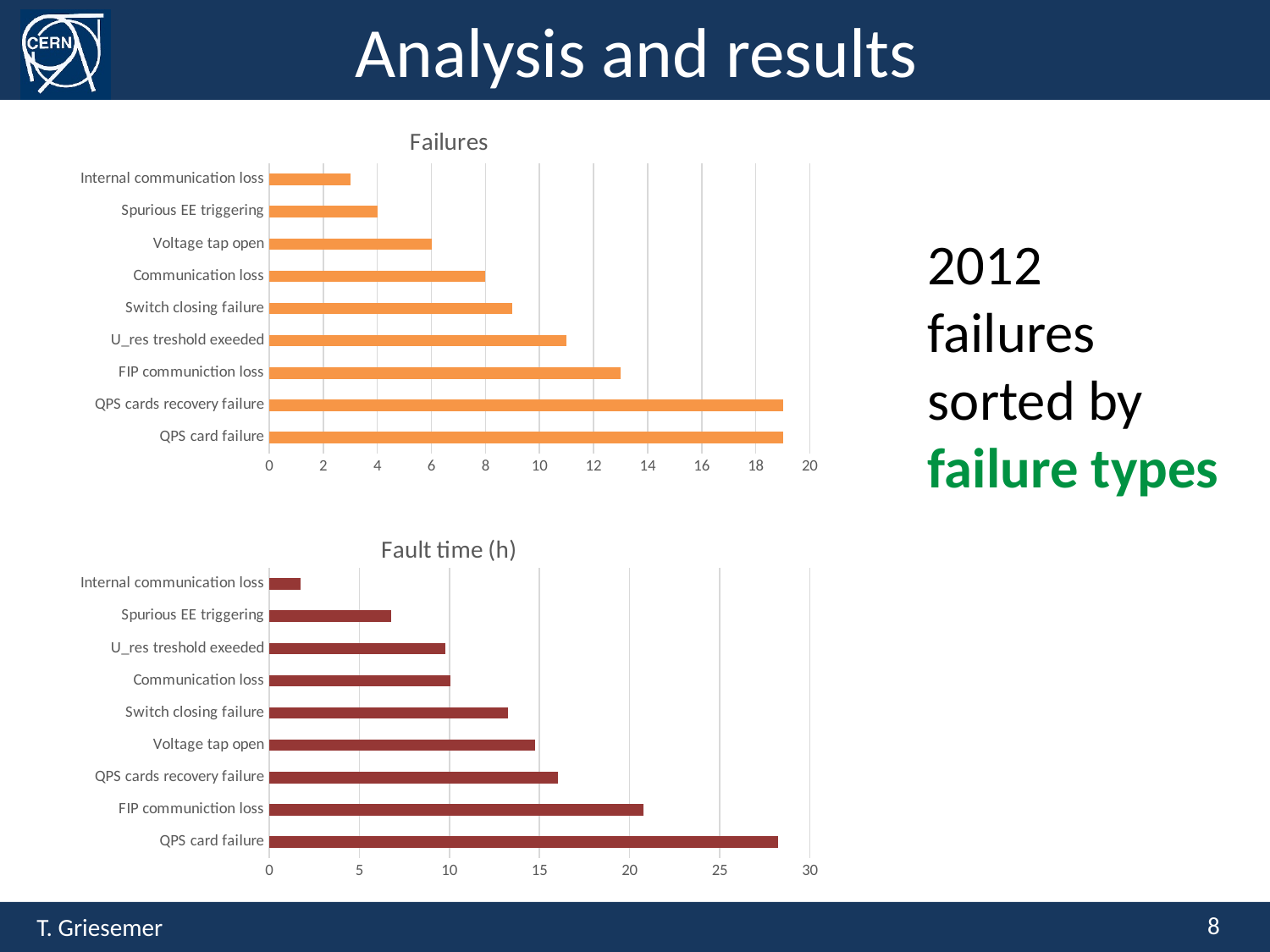
In the "Failures" chart, which category has the lowest value? Internal communication loss In the "Fault time (h)" chart, which category has the lowest value? Internal communication loss How many categories are shown in the "Failures" chart? 9 In the "Fault time (h)" chart, which category has the highest value? QPS card failure In the "Fault time (h)" chart, is the value for Spurious EE triggering greater or less than 10? less In the "Fault time (h)" chart, is the value for FIP communiction loss greater or less than 20? greater In the "Failures" chart, what is the value for Spurious EE triggering? 4 In the "Failures" chart, which is larger: U_res treshold exeeded or Switch closing failure? U_res treshold exeeded What type of chart is the top chart titled "Failures"? bar chart What is the title of the bottom chart on the slide? Fault time (h) In the "Failures" chart, is the value for FIP communiction loss greater or less than 12? greater In the "Failures" chart, what is the value for Communication loss? 8